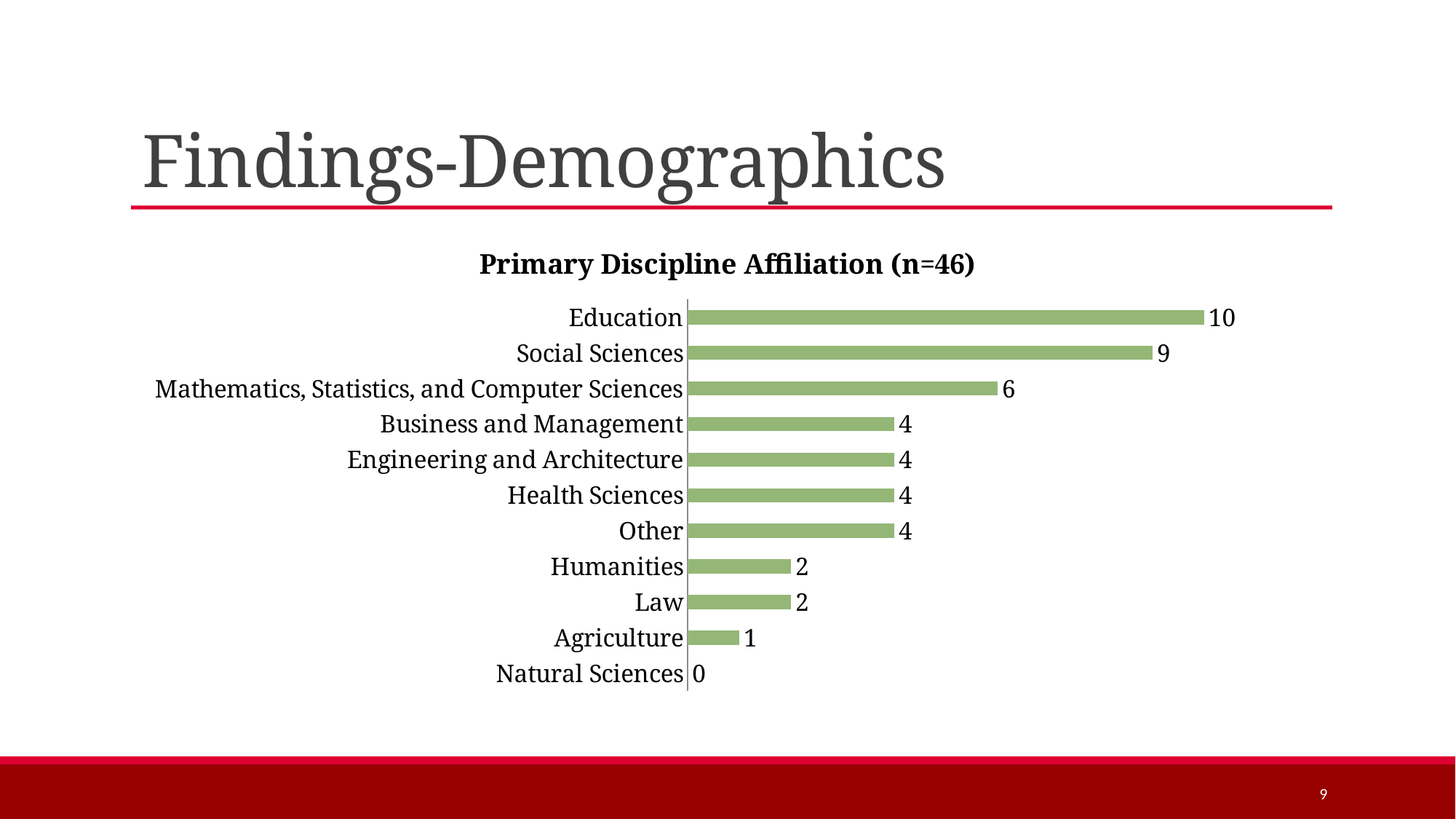
What is the title of the chart? Primary Discipline Affiliation (n=46) How many categories are shown in the chart? 11 Which category has the highest value? Education What is the difference between the values for Social Sciences and Humanities? 7 What is the value for Mathematics, Statistics, and Computer Sciences? 6 Which is larger, the value for Social Sciences or the value for Business and Management? Social Sciences Which category has the lowest value? Natural Sciences What is the value for Education? 10 What kind of chart is shown on the slide? Bar chart What is the difference between the values for Education and Social Sciences? 1 What is the value for Agriculture? 1 What is the value for Natural Sciences? 0